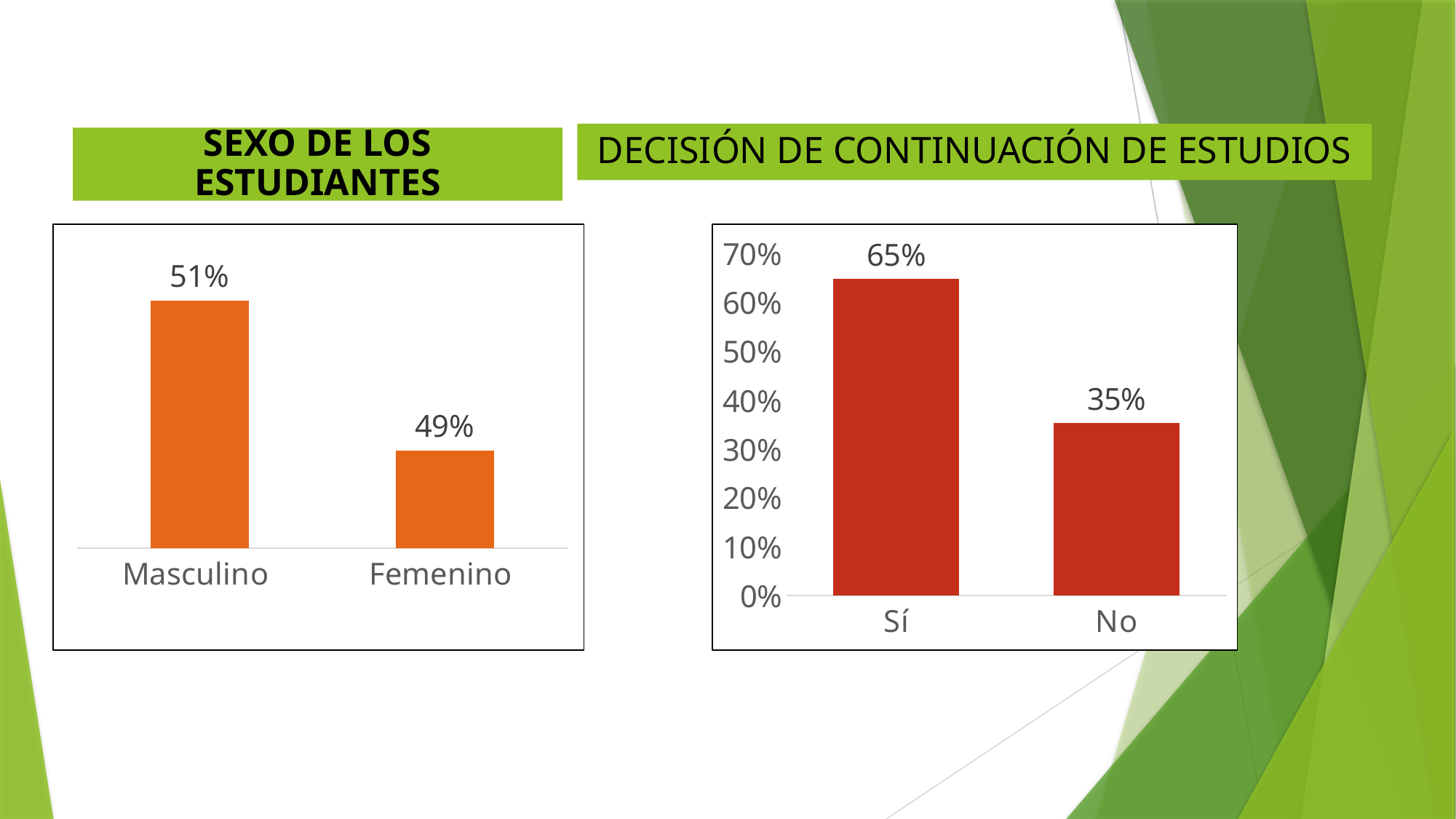
What kind of chart is the 'SEXO DE LOS ESTUDIANTES' chart? Bar chart In the 'DECISIÓN DE CONTINUACIÓN DE ESTUDIOS' chart, is the value for No greater or less than 40%? less In the 'DECISIÓN DE CONTINUACIÓN DE ESTUDIOS' chart, what is the value for Sí? 65% In the 'DECISIÓN DE CONTINUACIÓN DE ESTUDIOS' chart, what is the difference between the Sí and No values? 30% In the 'DECISIÓN DE CONTINUACIÓN DE ESTUDIOS' chart, what is the highest value shown on the vertical axis? 70% In the 'SEXO DE LOS ESTUDIANTES' chart, what is the difference between the Masculino and Femenino values? 2% In the 'DECISIÓN DE CONTINUACIÓN DE ESTUDIOS' chart, which category has the lowest value? No In the 'SEXO DE LOS ESTUDIANTES' chart, how many categories are shown? 2 In the 'DECISIÓN DE CONTINUACIÓN DE ESTUDIOS' chart, what is the value for No? 35% In the 'SEXO DE LOS ESTUDIANTES' chart, which category has the highest value? Masculino In the 'SEXO DE LOS ESTUDIANTES' chart, what is the value for Masculino? 51% In the 'SEXO DE LOS ESTUDIANTES' chart, what is the value for Femenino? 49%